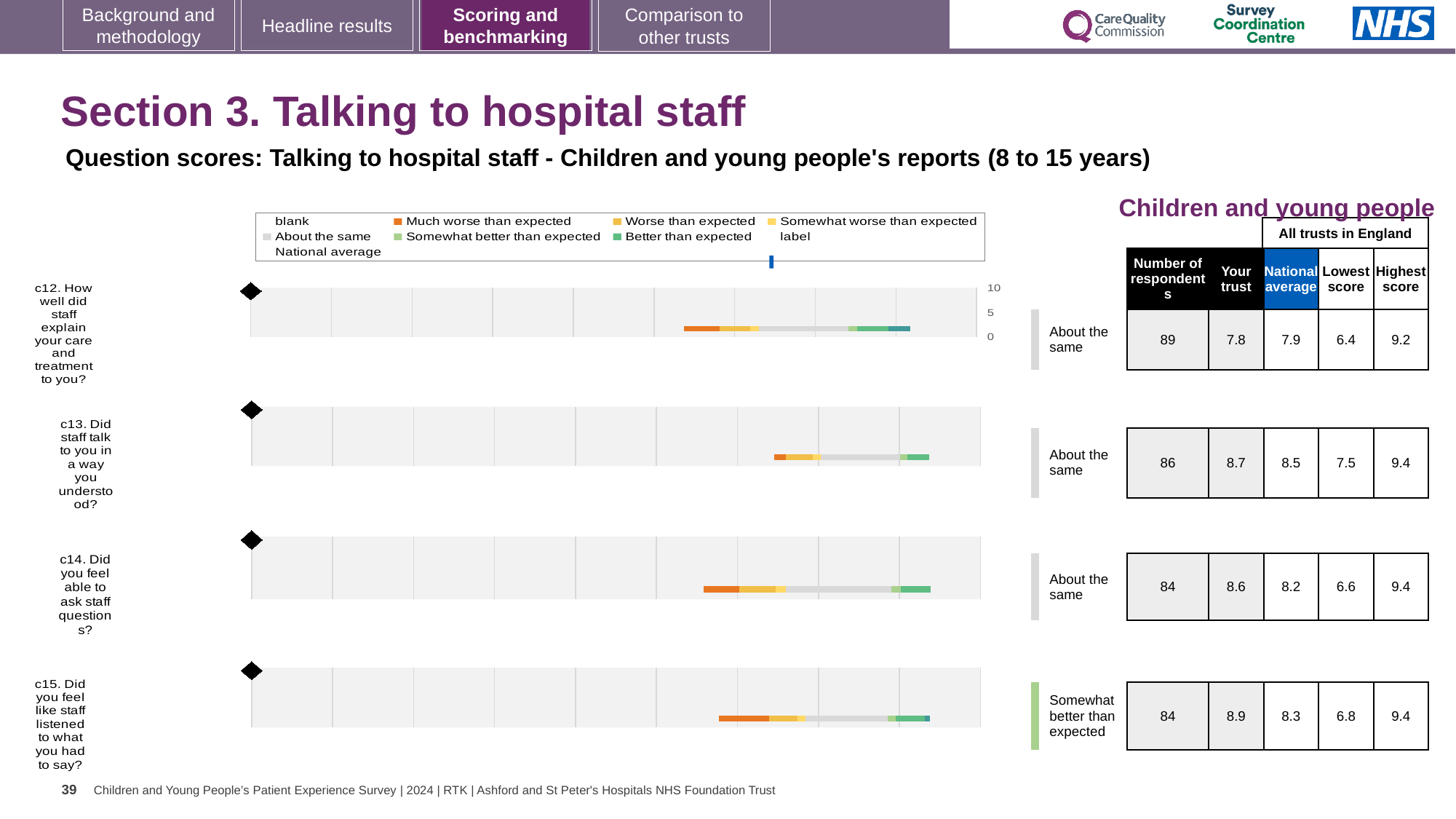
Is the 'Your trust' score for c14 higher or lower than the national average for c14? higher What is the number of respondents for c14 'Did you feel able to ask staff questions?' 84 What is the highest score across all trusts in England for c15 'Did you feel like staff listened to what you had to say?' 9.4 How many questions (c12 to c15) are charted on this slide? 4 What is the difference between the 'Your trust' score and the national average for c15? 0.6 Which question has the lowest 'Your trust' score? c12. How well did staff explain your care and treatment to you? Which question has the highest 'Your trust' score? c15. Did you feel like staff listened to what you had to say? What is the 'Your trust' score for c12 'How well did staff explain your care and treatment to you?' 7.8 How many categories does the chart legend list, including 'blank' and 'National average'? 9 What kind of chart is used to show the benchmark results for each question on this slide? bar chart What is the national average for c13 'Did staff talk to you in a way you understood?' 8.5 Which question is rated 'Somewhat better than expected' rather than 'About the same'? c15. Did you feel like staff listened to what you had to say?